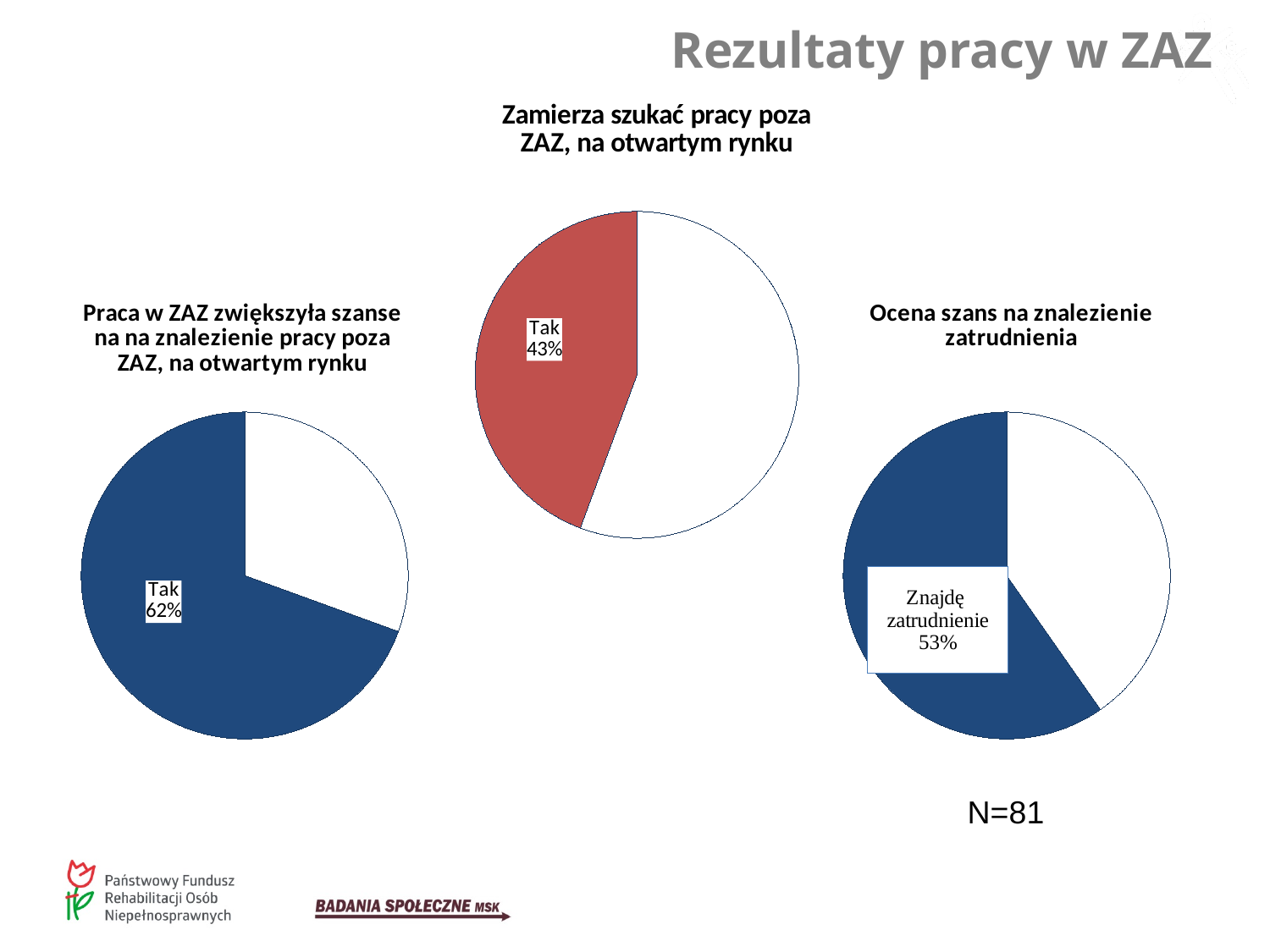
What sample size (N) is stated on the slide? N=81 In the chart titled "Ocena szans na znalezienie zatrudnienia", what percentage is shown for "Znajdę zatrudnienie"? 53% Which is larger: the "Tak" share in the chart "Praca w ZAZ zwiększyła szanse na na znalezienie pracy poza ZAZ, na otwartym rynku" or the "Tak" share in the chart "Zamierza szukać pracy poza ZAZ, na otwartym rynku"? Praca w ZAZ zwiększyła szanse na na znalezienie pracy poza ZAZ, na otwartym rynku In the chart titled "Zamierza szukać pracy poza ZAZ, na otwartym rynku", what percentage is shown for "Tak"? 43% In the chart titled "Praca w ZAZ zwiększyła szanse na na znalezienie pracy poza ZAZ, na otwartym rynku", what share of the pie does the "Tak" slice take? 62% What type of chart is the one titled "Zamierza szukać pracy poza ZAZ, na otwartym rynku"? Pie chart What is the difference in percentage points between the "Tak" share in the left chart (62%) and the "Tak" share in the middle chart (43%)? 19 percentage points In the chart titled "Praca w ZAZ zwiększyła szanse na na znalezienie pracy poza ZAZ, na otwartym rynku", what percentage is shown for "Tak"? 62% In the chart titled "Zamierza szukać pracy poza ZAZ, na otwartym rynku", is the "Tak" slice greater or less than 50% of the pie? less What colour is the labelled "Tak" slice in the chart titled "Zamierza szukać pracy poza ZAZ, na otwartym rynku"? Red How many slices does the pie chart titled "Ocena szans na znalezienie zatrudnienia" have? 2 Across the three pie charts on the slide, which chart has the smallest labelled slice? Zamierza szukać pracy poza ZAZ, na otwartym rynku